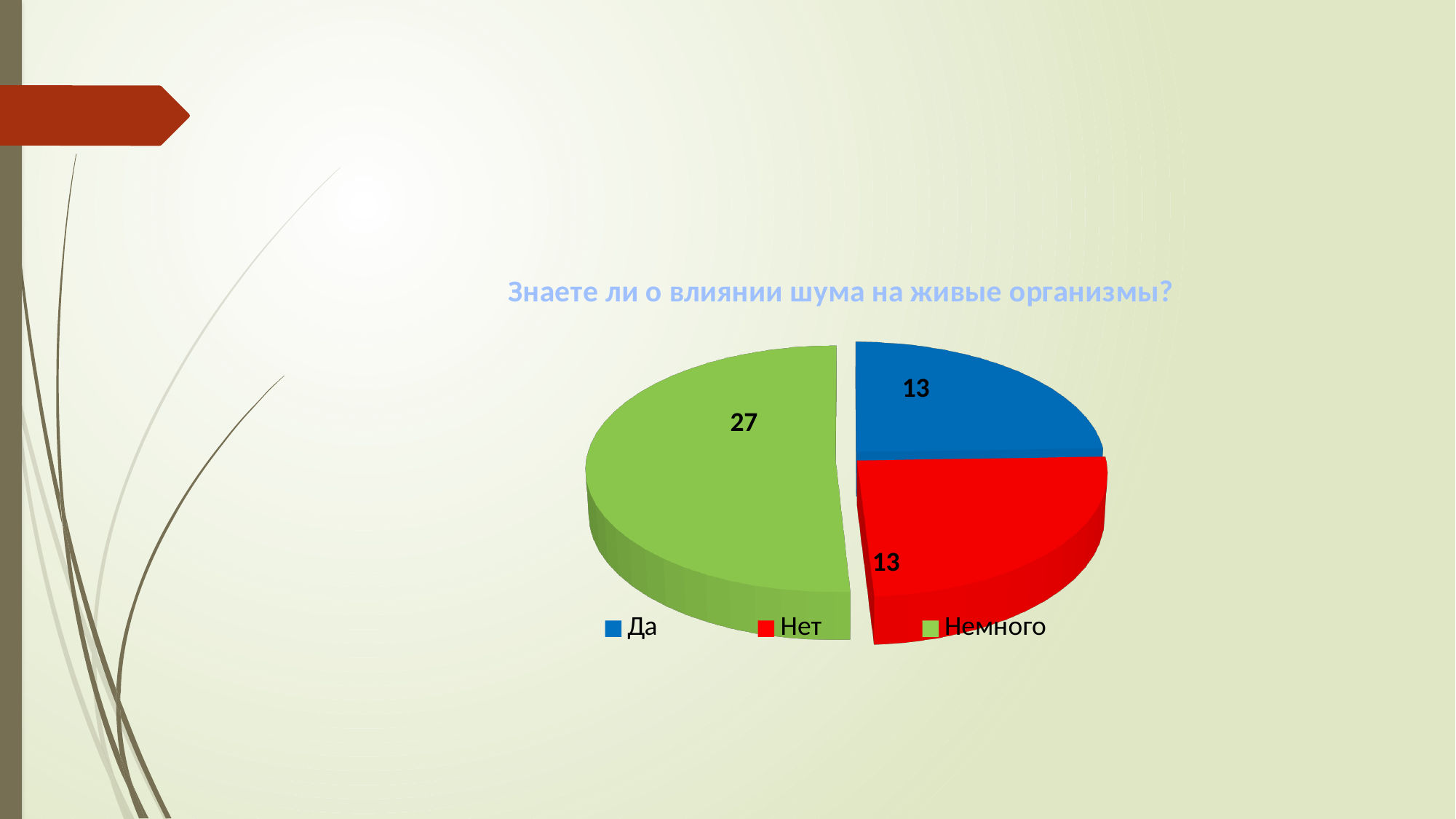
Which is larger, the value for "Немного" or the value for "Нет"? Немного What is the value for the "Нет" slice? 13 What is the value for the "Немного" slice? 27 Which category has the largest slice? Немного How many slices does the pie chart have? 3 What is the value for the "Да" slice? 13 What is the title of the chart? Знаете ли о влиянии шума на живые организмы? Which colour represents the "Нет" category in the legend? Red How many categories does the legend list? 3 What is the total of all three slices? 53 What is the difference between the values for "Немного" and "Да"? 14 What kind of chart is shown on the slide? Pie chart